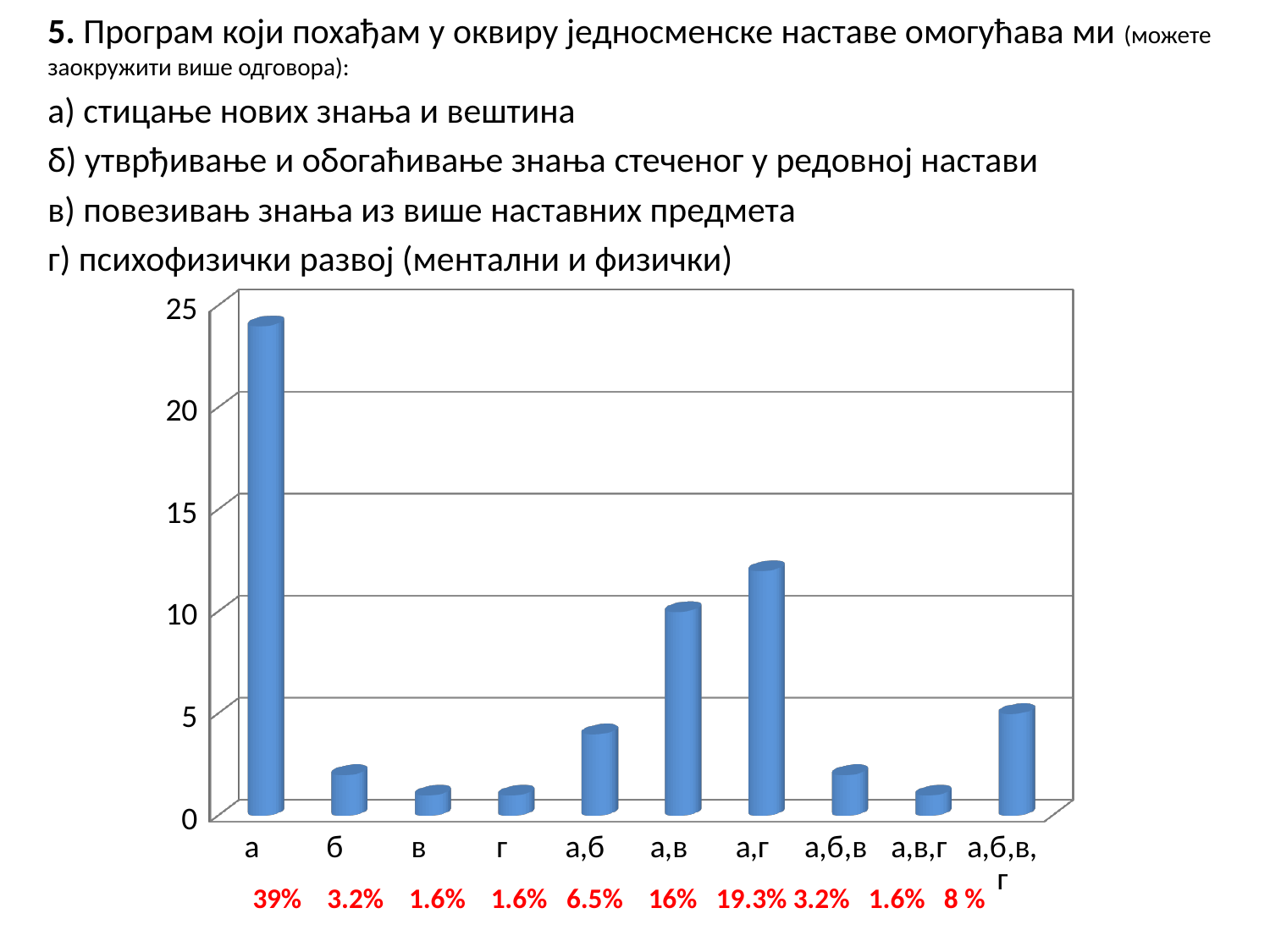
Is the value for category а,г greater or less than 10? greater What kind of chart is shown on the slide? bar chart Is the value for category а,б greater or less than 5? less What percentage is printed beneath the bar for category а,г? 19.3% What percentage is printed beneath the bar for category а,б,в,г? 8 % Which category has the highest bar in the chart? а What is the highest value shown on the vertical axis of the chart? 25 Which bar is taller, а,г or а,в? а,г How many categories are shown on the x axis of the chart? 10 Which bar is taller, а,б or б? а,б Is the value for category б greater or less than 5? less